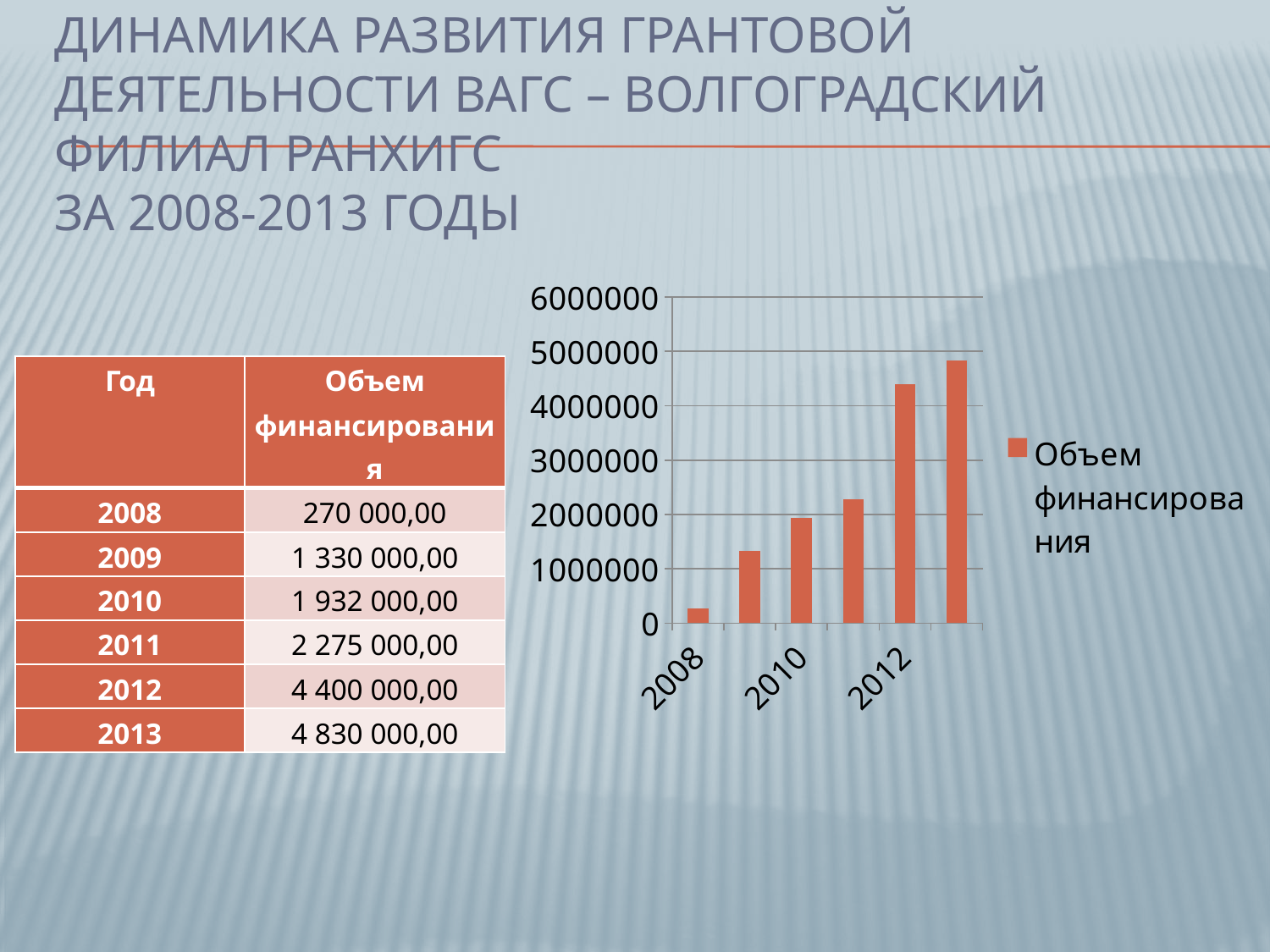
Which is larger, the value for 2010 or the value for 2011? 2011 Which year has the lowest value in the chart? 2008 What is the name of the series shown in the chart legend? Объем финансирования Is the value for 2008 in the chart greater or less than 1000000? less Is the value for 2012 in the chart greater or less than 4000000? greater What kind of chart is shown on the slide? bar chart How many series does the chart legend list? 1 Is the value for 2013 in the chart greater or less than 5000000? less According to the table on the slide, what is the funding volume (Объем финансирования) for 2011? 2 275 000,00 Which year has the highest value in the chart? 2013 How many bars are plotted in the chart? 6 Do the values in the chart rise or fall from 2008 to 2013? rise